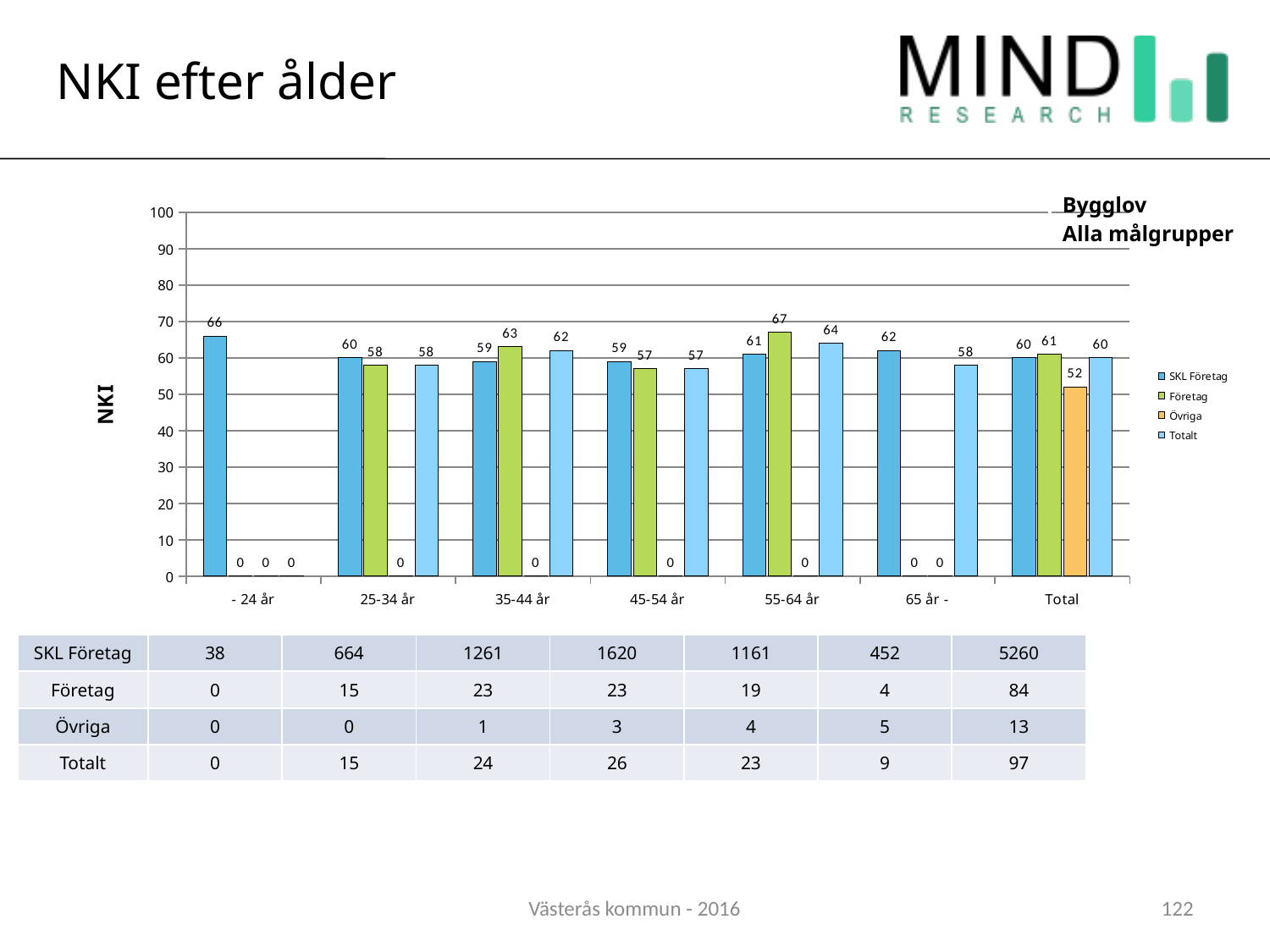
What kind of chart is shown on the slide? Bar chart Among the age groups with a non-zero Totalt value, which has the lowest Totalt value? 45-54 år How many age categories (including Total) are shown on the x axis? 7 What is the Företag value for the 55-64 år age group? 67 What is the SKL Företag value for the - 24 år age group? 66 Which age group has the highest Företag value? 55-64 år How many series does the legend list? 4 What is the difference between the Företag value and the SKL Företag value for the 55-64 år age group? 6 What is the label on the vertical axis of the chart? NKI What is the Totalt value for the 35-44 år age group? 62 What is the Övriga value in the Total category? 52 Which is larger for the 45-54 år age group, the SKL Företag value or the Företag value? SKL Företag